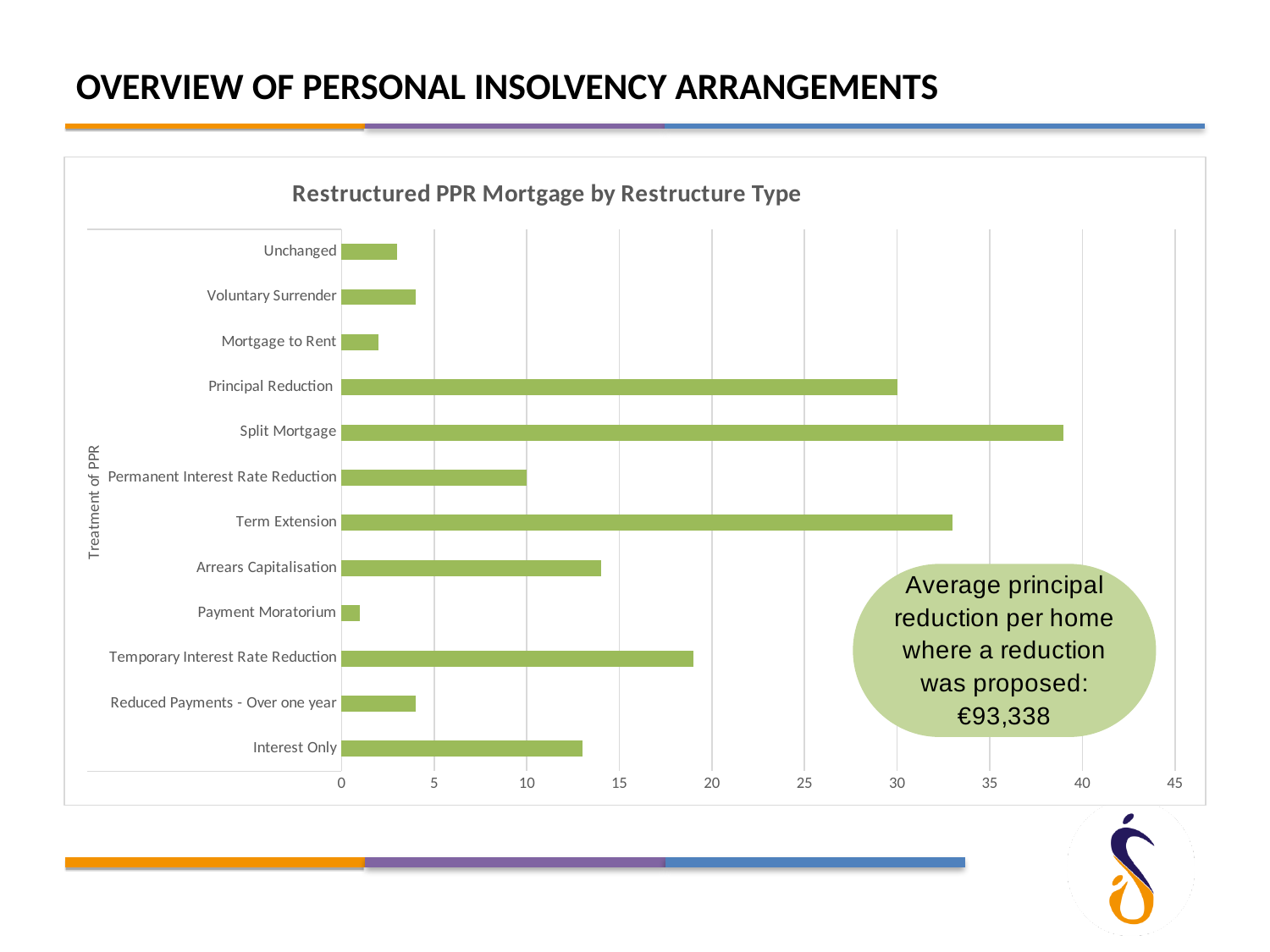
Is the value for Arrears Capitalisation greater or less than 10? greater What is the label on the vertical axis of the chart? Treatment of PPR What is the value for Principal Reduction? 30 How many restructure types are plotted in the chart? 12 Is the value for Temporary Interest Rate Reduction greater or less than 20? less What is the title of the chart? Restructured PPR Mortgage by Restructure Type What is the value for Permanent Interest Rate Reduction? 10 Which restructure type has the highest value? Split Mortgage Which restructure type has the lowest value? Payment Moratorium Which is larger, the value for Term Extension or the value for Principal Reduction? Term Extension What kind of chart is shown on the slide? bar chart Is the value for Split Mortgage greater or less than 35? greater